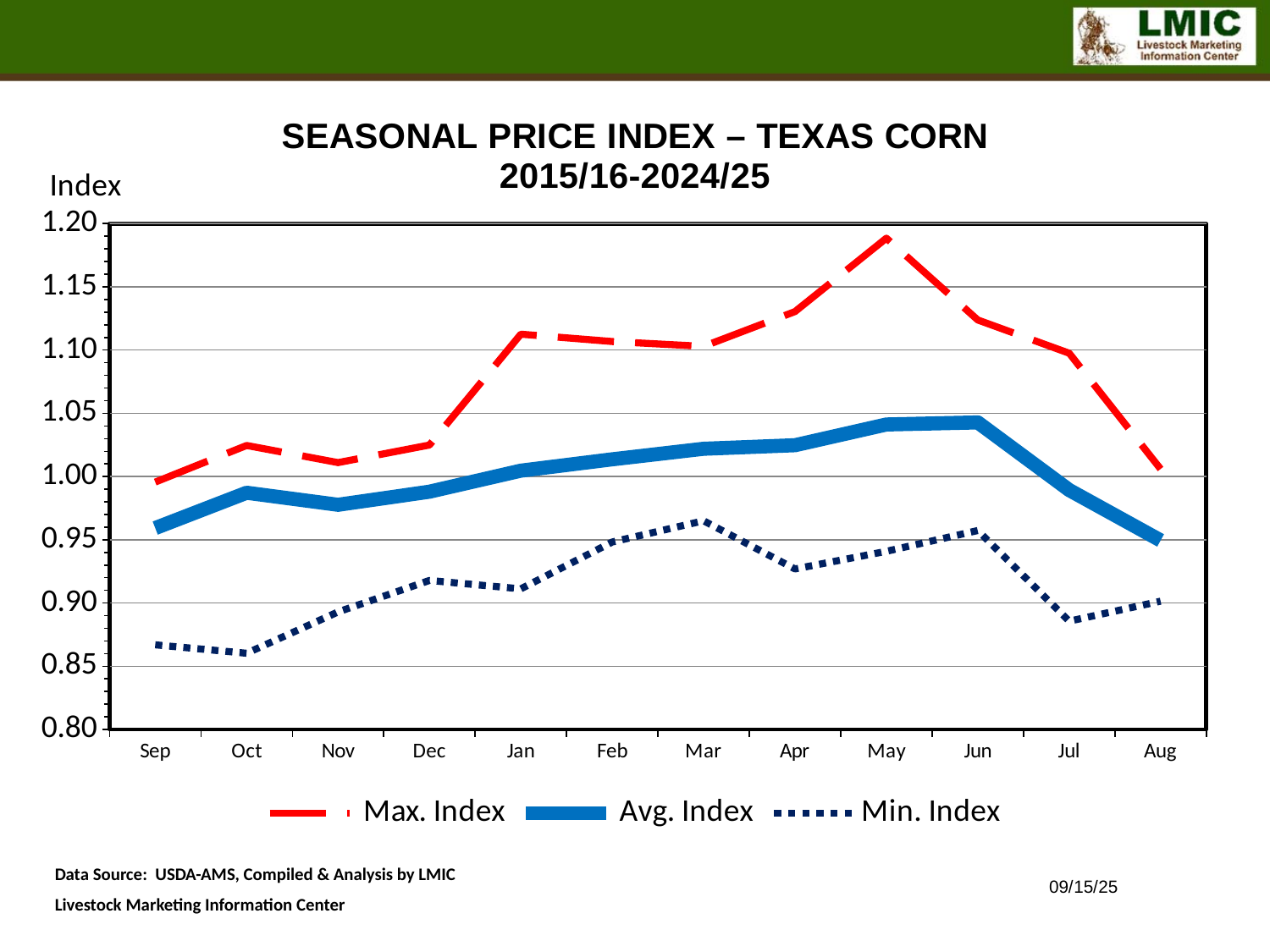
Is the Avg. Index value for Apr greater or less than 1.00? greater How many series does the legend list? 3 Is the Max. Index value for May greater or less than 1.15? greater Which is larger, the Min. Index in Mar or the Min. Index in Oct? Mar Is the Min. Index value for Sep greater or less than 0.90? less Does the Max. Index rise or fall from Jun to Aug? Fall Which is larger, the Max. Index in May or the Max. Index in Jan? May What is the title of the chart? SEASONAL PRICE INDEX – TEXAS CORN 2015/16-2024/25 How many months are plotted along the x axis? 12 In which month does the Max. Index reach its highest value? May What kind of chart is shown on the slide? Line chart